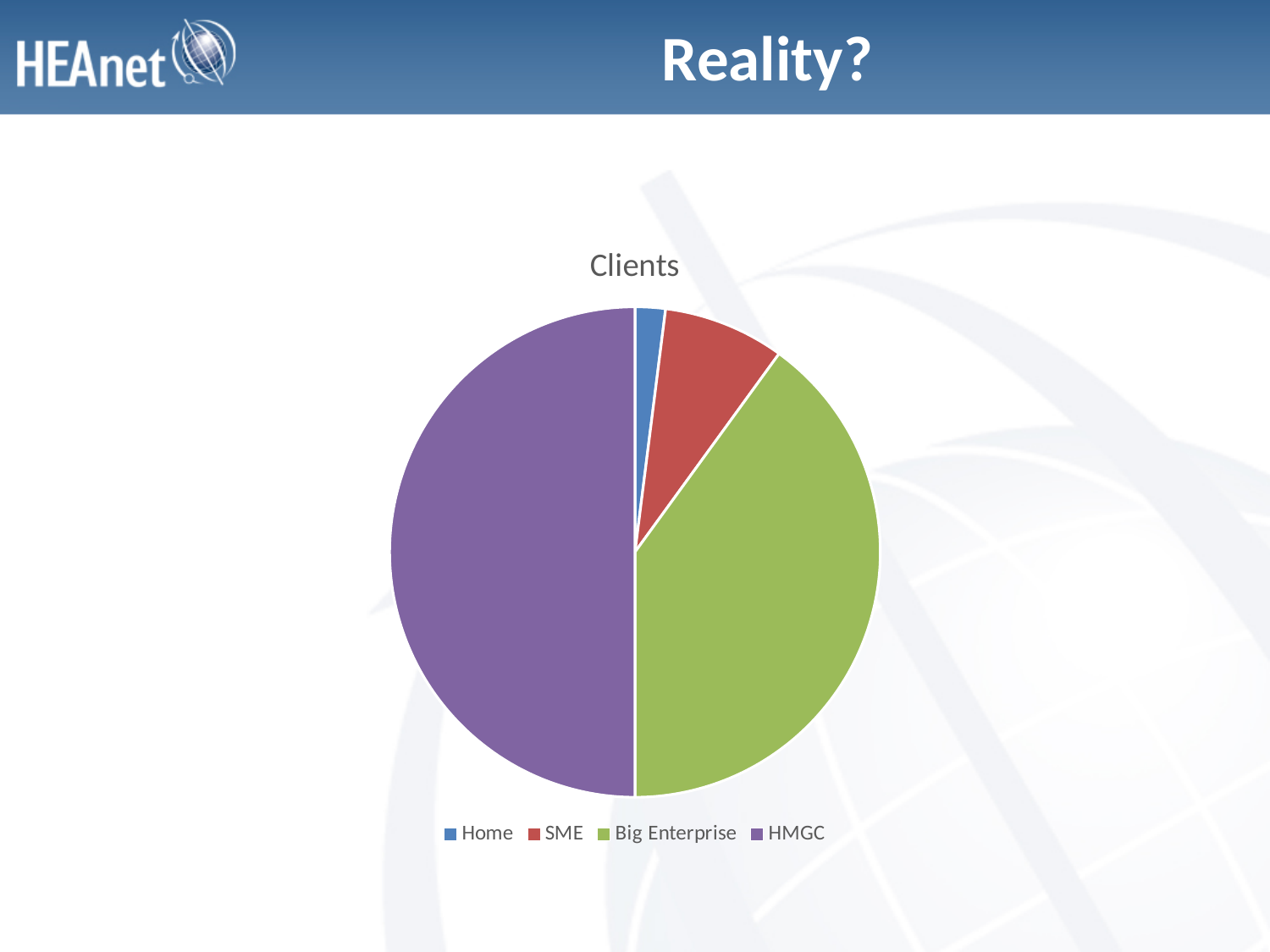
Which category has the largest slice of the pie? HMGC How many entries does the legend list? 4 Which slice is larger, Big Enterprise or SME? Big Enterprise What colour is the HMGC slice? Purple Which slice is larger, SME or Home? SME What kind of chart is shown on the slide? Pie chart Which slice is larger, HMGC or Big Enterprise? HMGC What is the title of the chart? Clients How many categories (slices) does the pie chart have? 4 Which category has the smallest slice of the pie? Home